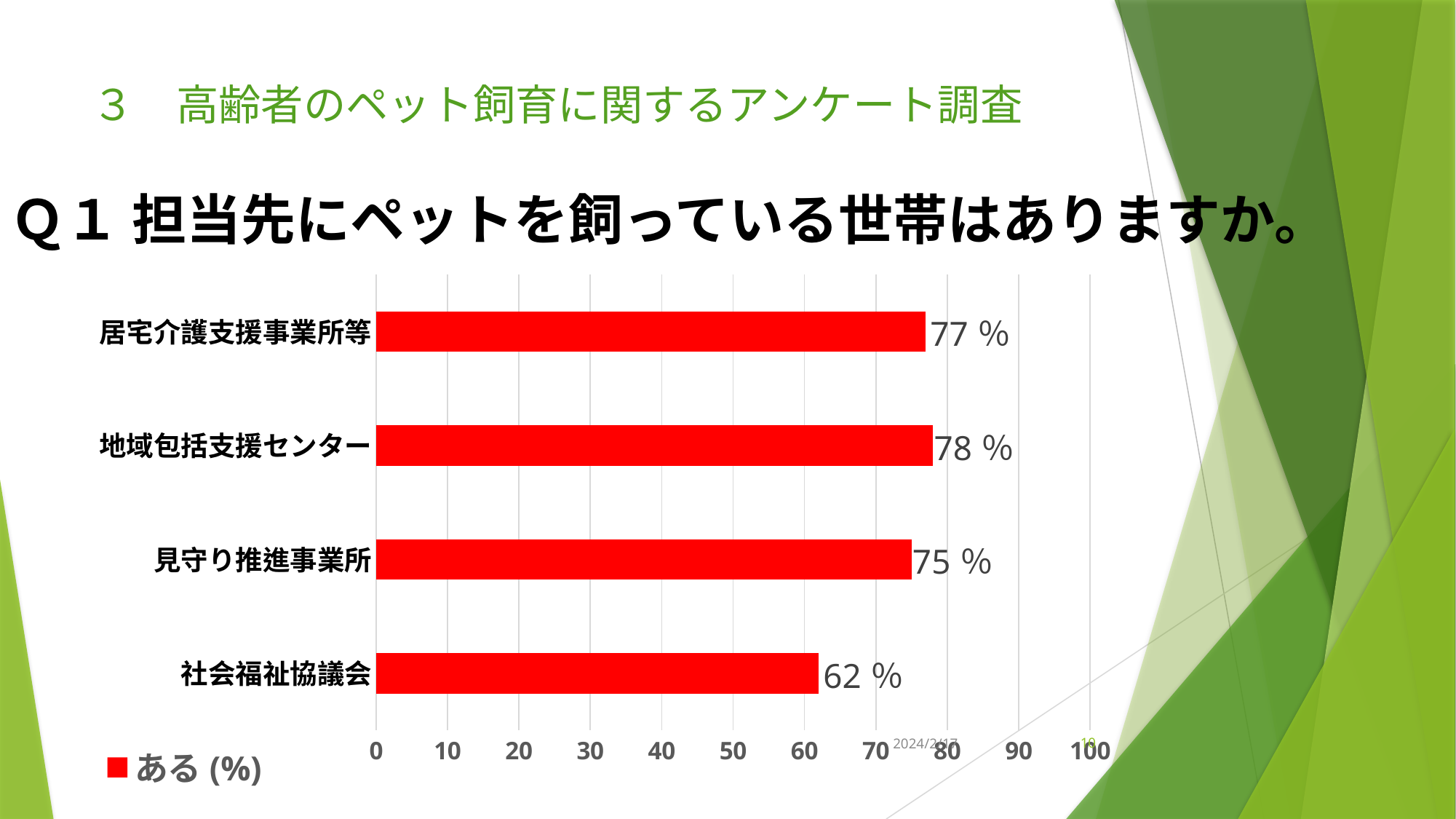
What is the difference between the values for 地域包括支援センター and 社会福祉協議会? 16 % What is the value for 地域包括支援センター? 78 % What is the value for 社会福祉協議会? 62 % How many series does the legend list? 1 What is the value for 居宅介護支援事業所等? 77 % Which category has the lowest value? 社会福祉協議会 Is the value for 社会福祉協議会 greater or less than 70? less What kind of chart is shown on the slide? bar chart What is the value for 見守り推進事業所? 75 % Which category has the highest value? 地域包括支援センター How many categories are shown in the chart? 4 Which is larger, the value for 見守り推進事業所 or the value for 社会福祉協議会? 見守り推進事業所